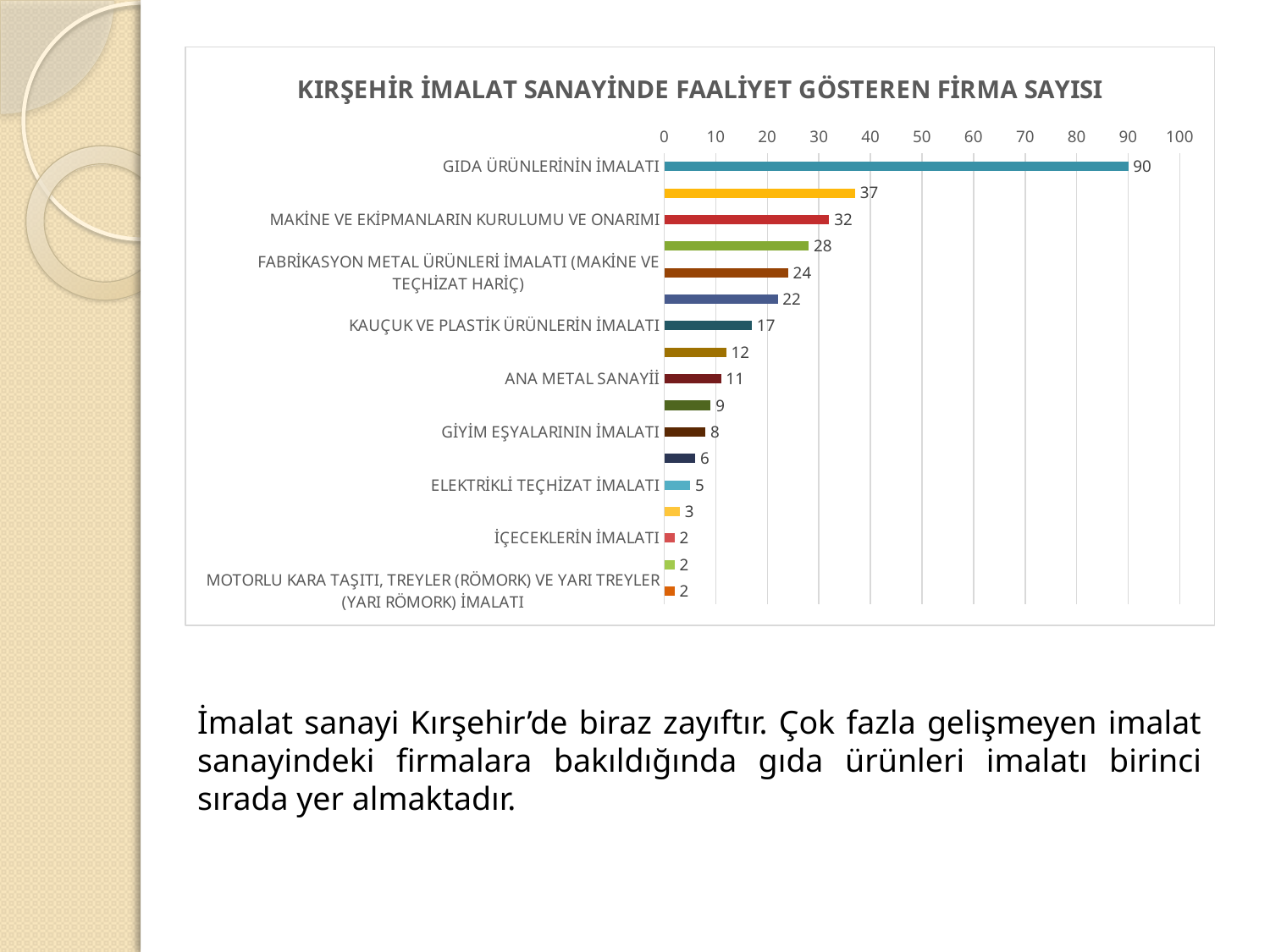
Which is larger, the value for GİYİM EŞYALARININ İMALATI or the value for ELEKTRİKLİ TEÇHİZAT İMALATI? GİYİM EŞYALARININ İMALATI What is the value for ANA METAL SANAYİİ? 11 What is the lowest value shown in the chart? 2 What type of chart is shown on the slide? bar chart Which category has the highest number of firms? GIDA ÜRÜNLERİNİN İMALATI How many bars are plotted in the chart? 17 What is the value for MAKİNE VE EKİPMANLARIN KURULUMU VE ONARIMI? 32 What is the value for ELEKTRİKLİ TEÇHİZAT İMALATI? 5 What is the value for KAUÇUK VE PLASTİK ÜRÜNLERİN İMALATI? 17 How many firms are shown for GIDA ÜRÜNLERİNİN İMALATI? 90 What is the title of the chart? KIRŞEHİR İMALAT SANAYİNDE FAALİYET GÖSTEREN FİRMA SAYISI What is the difference between the values for GIDA ÜRÜNLERİNİN İMALATI and MAKİNE VE EKİPMANLARIN KURULUMU VE ONARIMI? 58